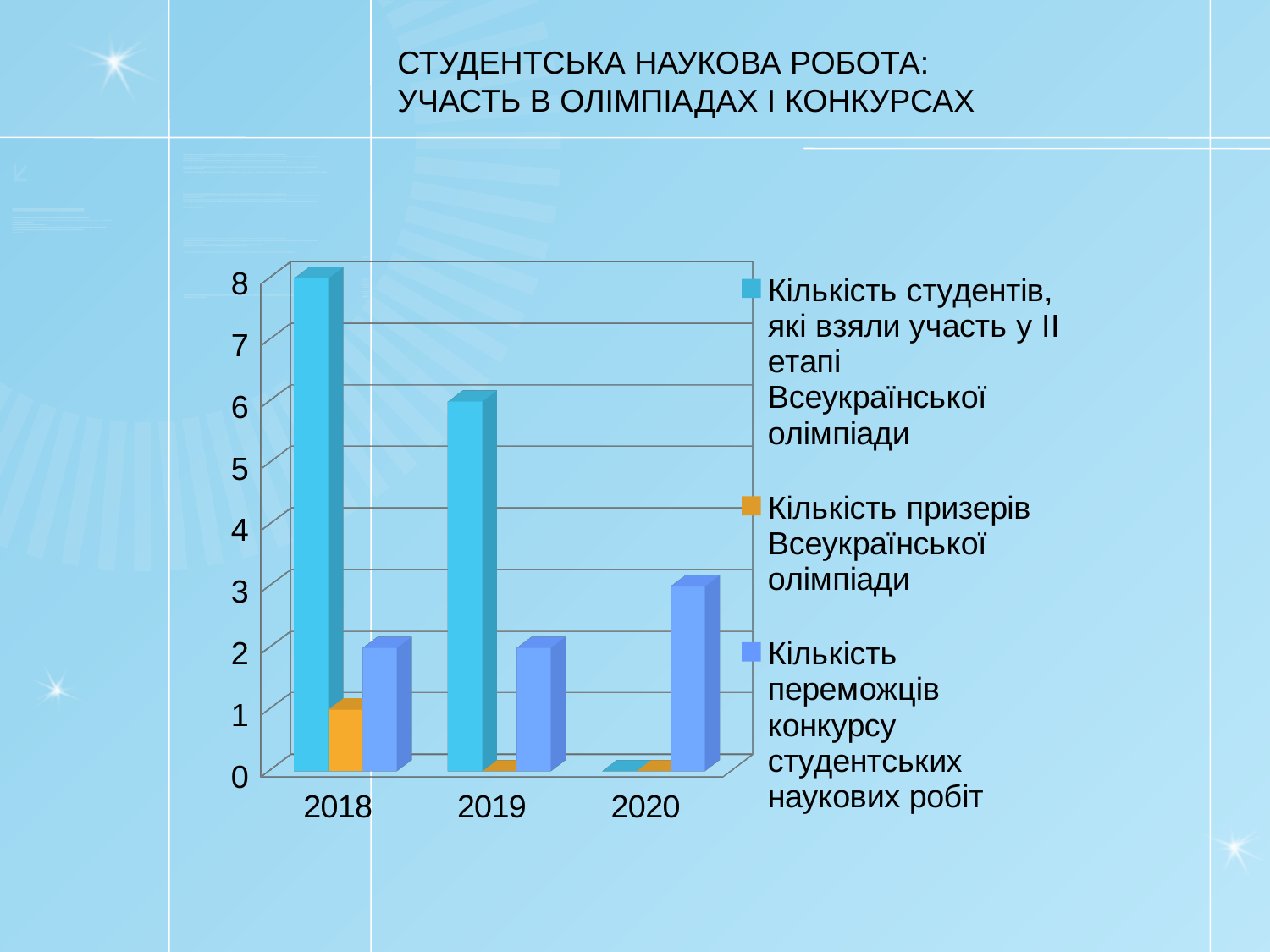
Which is larger in 2019: 'Кількість студентів, які взяли участь у ІІ етапі Всеукраїнської олімпіади' or 'Кількість переможців конкурсу студентських наукових робіт'? Кількість студентів, які взяли участь у ІІ етапі Всеукраїнської олімпіади Which year has the highest value for 'Кількість переможців конкурсу студентських наукових робіт'? 2020 How many series does the legend list? 3 Do the values for 'Кількість студентів, які взяли участь у ІІ етапі Всеукраїнської олімпіади' rise or fall from 2018 to 2020? fall What is the title of the slide? СТУДЕНТСЬКА НАУКОВА РОБОТА: УЧАСТЬ В ОЛІМПІАДАХ І КОНКУРСАХ Is the value for 'Кількість студентів, які взяли участь у ІІ етапі Всеукраїнської олімпіади' in 2018 greater or less than 7? greater Which year has the highest value for 'Кількість студентів, які взяли участь у ІІ етапі Всеукраїнської олімпіади'? 2018 What kind of chart is shown on the slide? bar chart Is the value for 'Кількість призерів Всеукраїнської олімпіади' in 2018 greater or less than 2? less How many years are shown on the x axis? 3 Is the value for 'Кількість переможців конкурсу студентських наукових робіт' in 2020 greater or less than 2? greater